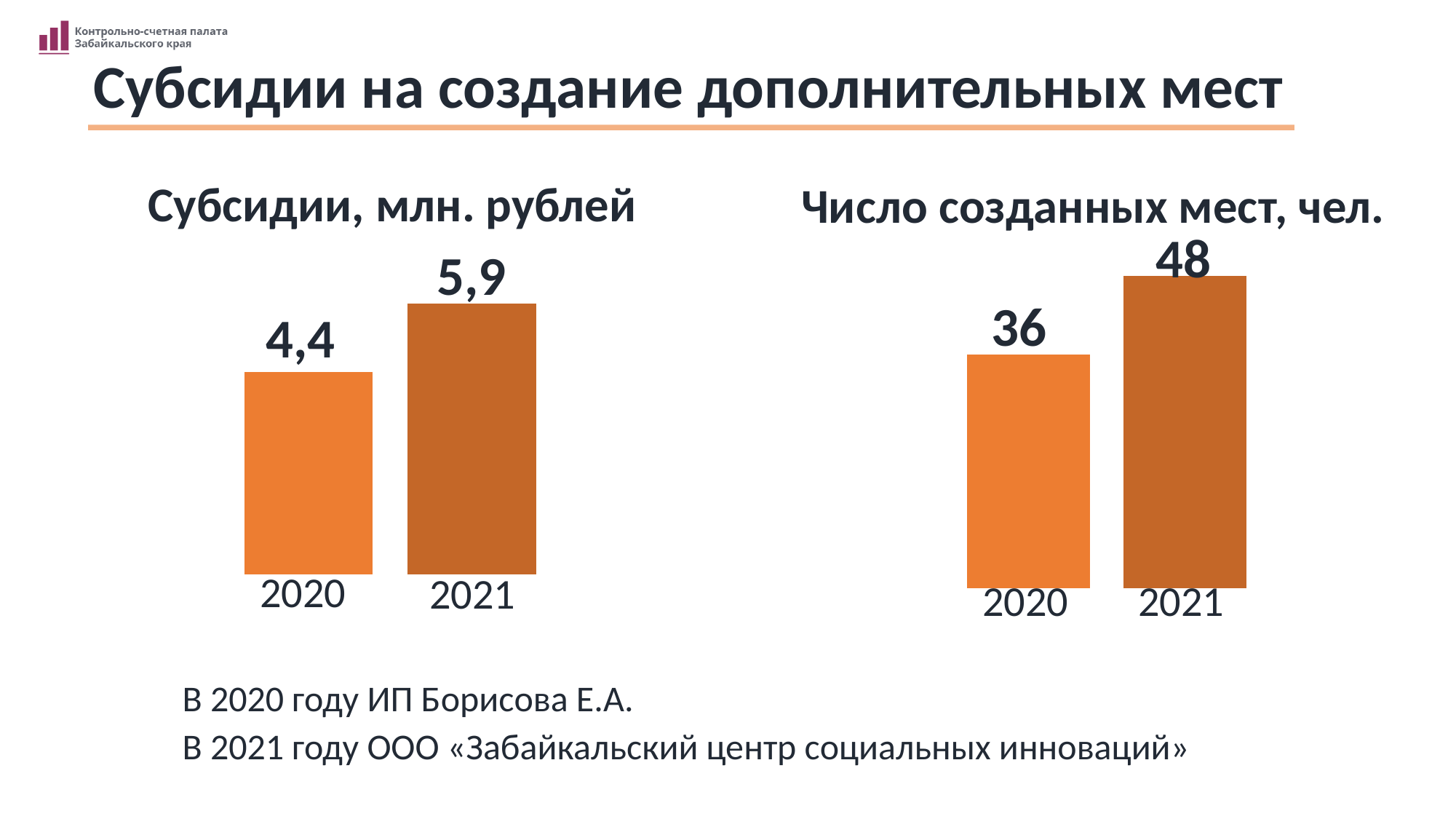
In the chart titled "Субсидии, млн. рублей", what is the value for 2021? 5,9 In the chart titled "Число созданных мест, чел.", is the value for 2021 larger or smaller than the value for 2020? larger How many categories are shown in the chart titled "Субсидии, млн. рублей"? 2 What kind of chart is the chart titled "Число созданных мест, чел."? bar chart In the chart titled "Субсидии, млн. рублей", do the values rise or fall from 2020 to 2021? rise In the chart titled "Число созданных мест, чел.", what is the value for 2021? 48 In the chart titled "Субсидии, млн. рублей", what is the value for 2020? 4,4 In the chart titled "Субсидии, млн. рублей", what is the difference between the 2021 and 2020 values? 1,5 In the chart titled "Число созданных мест, чел.", what is the difference between the 2021 and 2020 values? 12 In the chart titled "Число созданных мест, чел.", what is the value for 2020? 36 In the chart titled "Субсидии, млн. рублей", which year has the higher value? 2021 In the chart titled "Число созданных мест, чел.", which year has the lower value? 2020